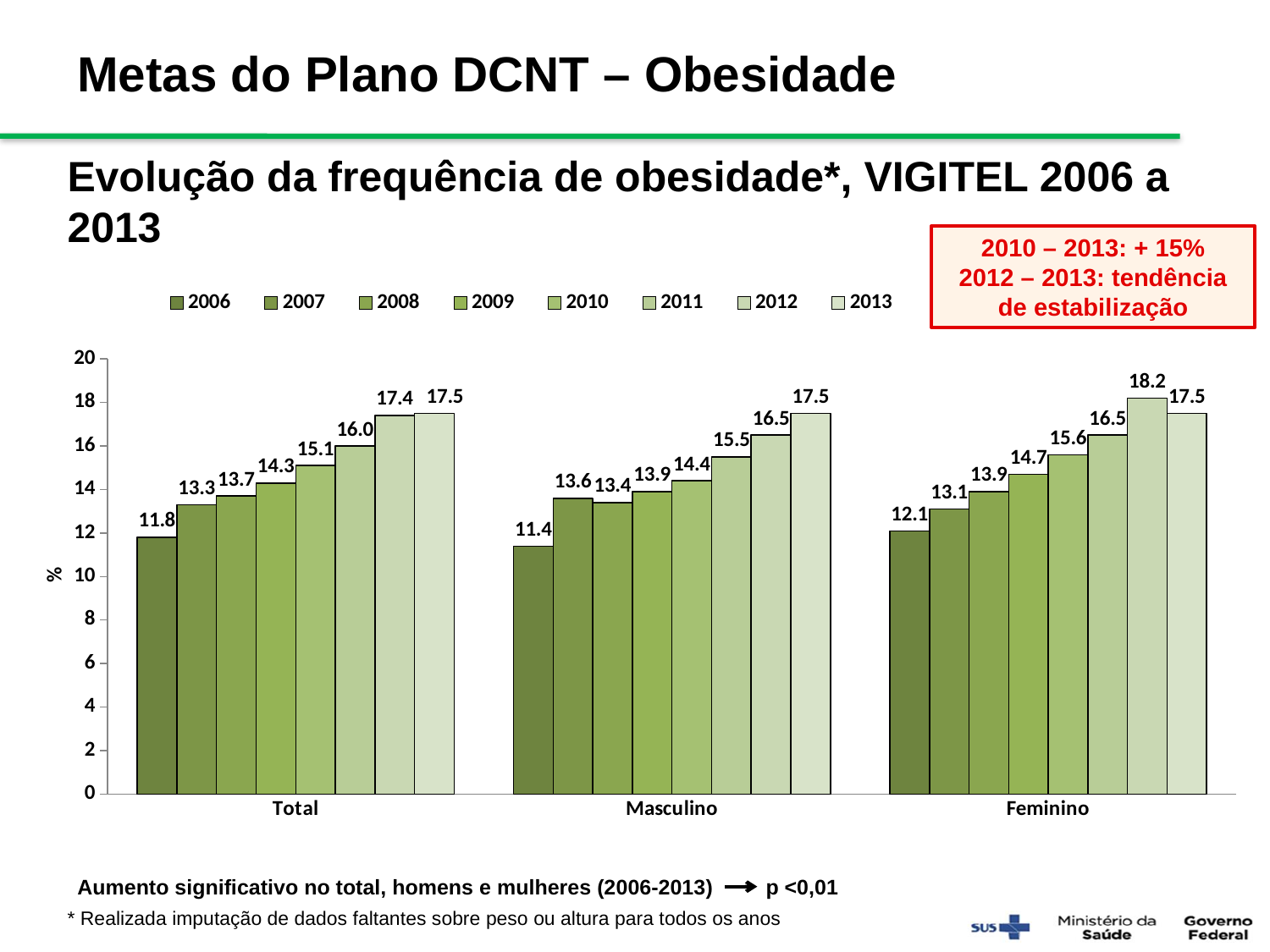
What is the value for Feminino in 2012? 18.2 What is the value for Total in 2006? 11.8 What kind of chart is shown on the slide? bar chart For Masculino, which year has the larger value, 2007 or 2008? 2007 Do the Total values generally rise or fall from 2006 to 2013? rise What is the label on the y axis? % In which year is the Masculino value lowest? 2006 How many categories are shown on the x axis? 3 In which year is the Feminino value highest? 2012 What is the difference between the Total values for 2013 and 2006? 5.7 How many series does the legend list? 8 What is the value for Masculino in 2013? 17.5